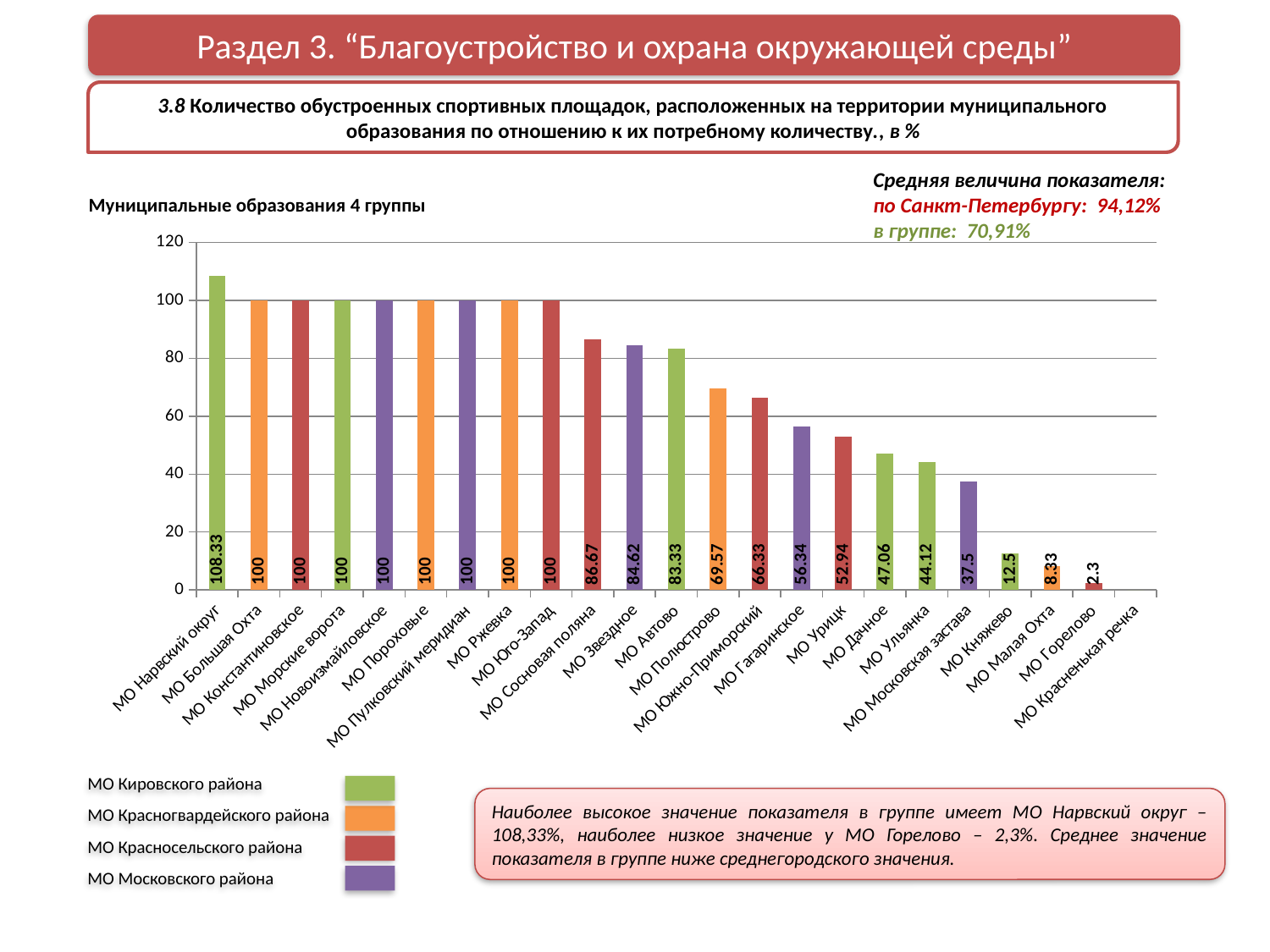
Which municipality has the highest value on the chart? МО Нарвский округ Is the value for МО Гагаринское greater or less than 60? less Which is larger, the value for МО Урицк or the value for МО Дачное? МО Урицк How many municipalities are listed along the x axis? 23 Which municipality with a labelled bar has the lowest value? МО Горелово What is the value for МО Полюстрово? 69.57 How many entries does the legend list? 4 What is the value for МО Московская застава? 37.5 What is the value for МО Сосновая поляна? 86.67 What is the difference between the values for МО Нарвский округ and МО Горелово? 106.03 Which district do the purple bars represent according to the legend? МО Московского района What kind of chart is shown on the slide? bar chart